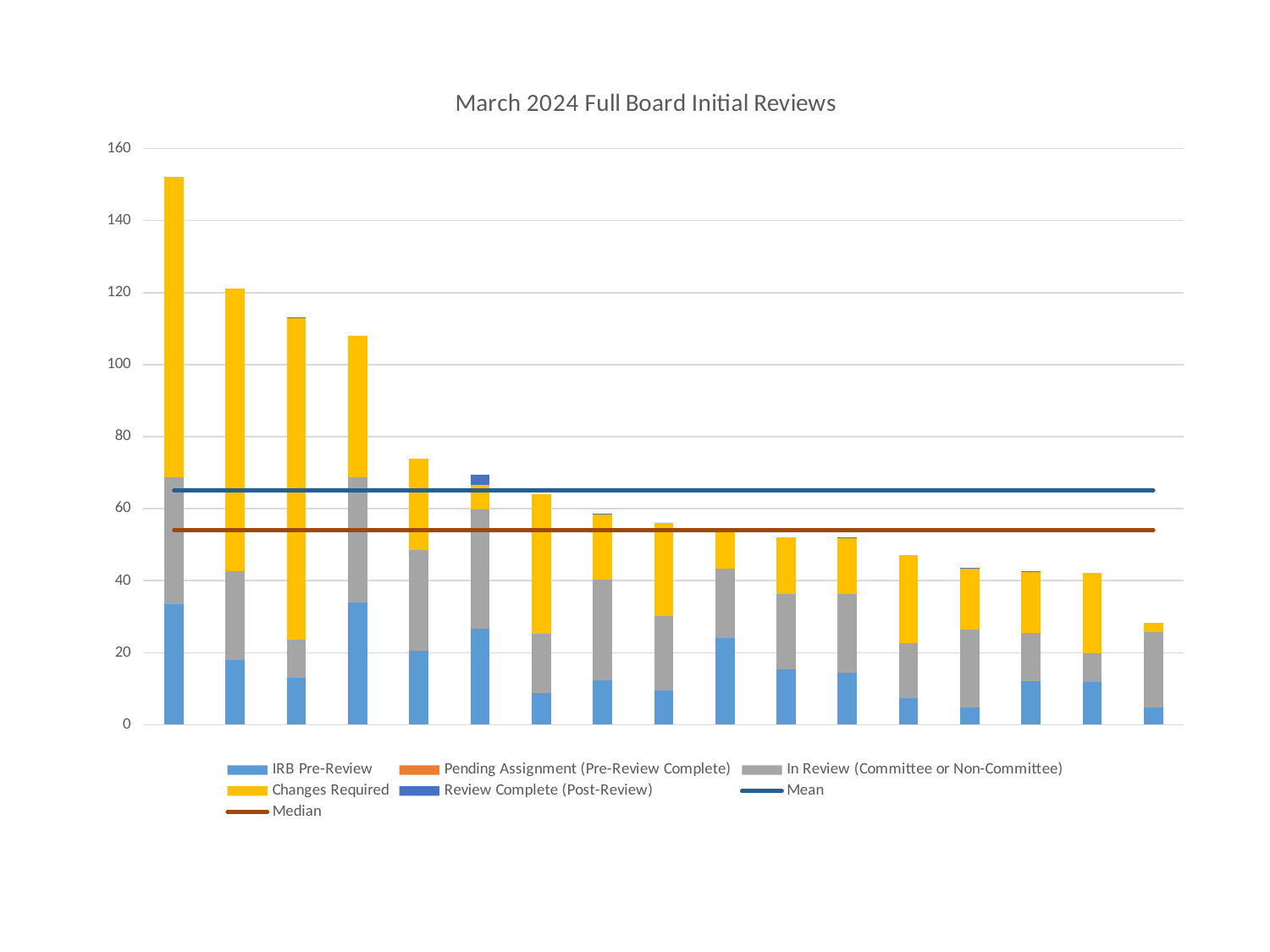
Is the Median line greater or less than 60? less Which bar has the highest total, counting from the left? the first (leftmost) bar Is the total of the leftmost bar greater or less than 140? greater Do the bar totals generally rise or fall from left to right along the x axis? fall How many bars are plotted in the chart? 17 Is the Mean line greater or less than 60? greater What kind of chart is shown on the slide? stacked bar chart with Mean and Median lines (combination bar and line chart) What is the title of the chart? March 2024 Full Board Initial Reviews Which is larger, the Mean line or the Median line? Mean How many entries does the legend list? 7 Which bar has the lowest total, counting from the left? the last (rightmost) bar